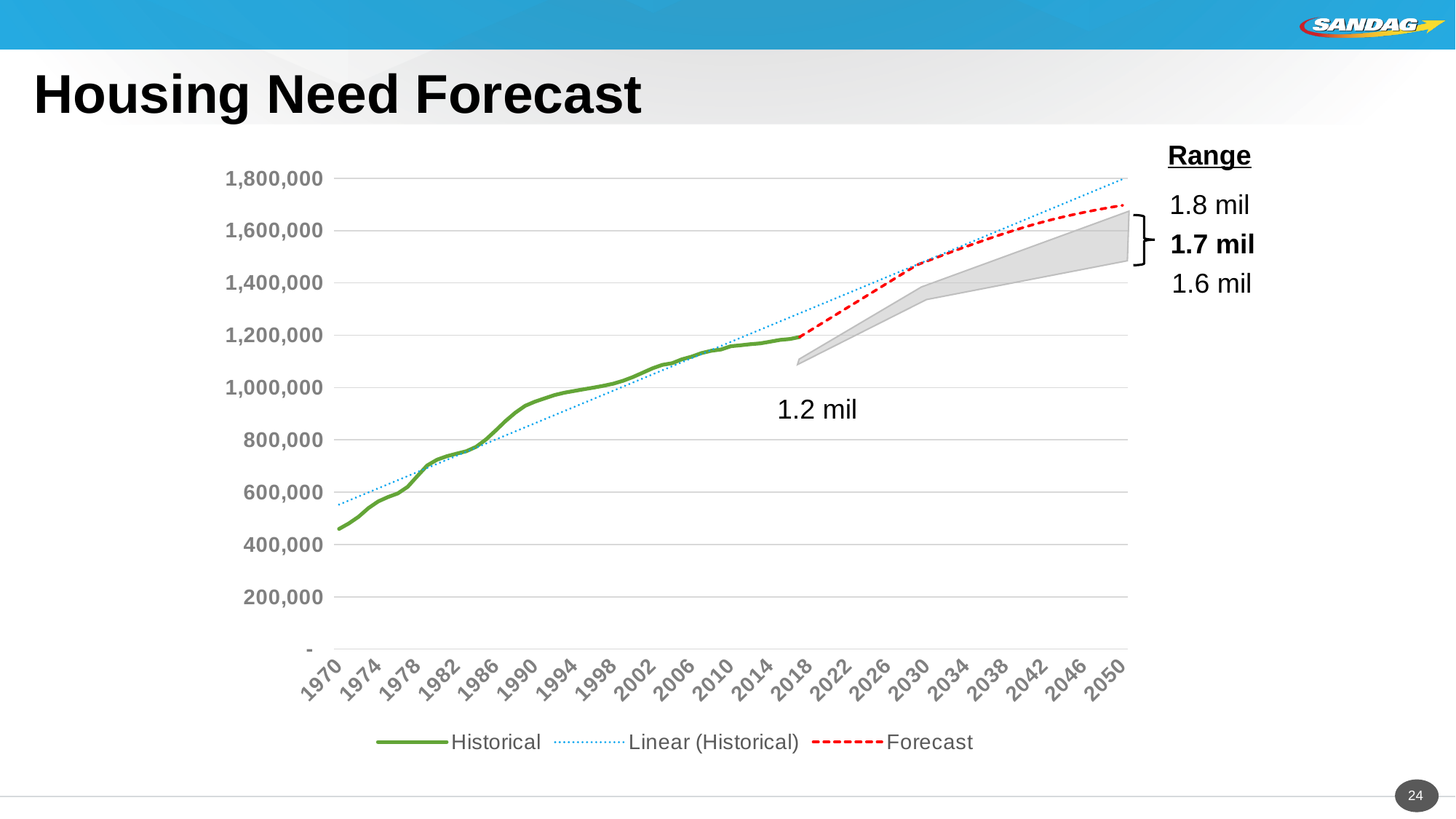
Which series is drawn as a red dashed line? Forecast What kind of chart is shown on the slide? line chart Is the Historical value for 1990 greater or less than 800,000? greater How many series does the legend list? 3 What is the title of the chart on the slide? Housing Need Forecast What is the bold central value of the Range shown for 2050? 1.7 mil Is the Forecast value for 2050 greater or less than 1,600,000? greater What value is annotated on the chart for 2018? 1.2 mil What is the upper end of the Range shown for 2050? 1.8 mil Does the Historical series rise or fall from 1970 to 2018? rise Is the Historical value for 1970 greater or less than 600,000? less What is the lower end of the Range shown for 2050? 1.6 mil